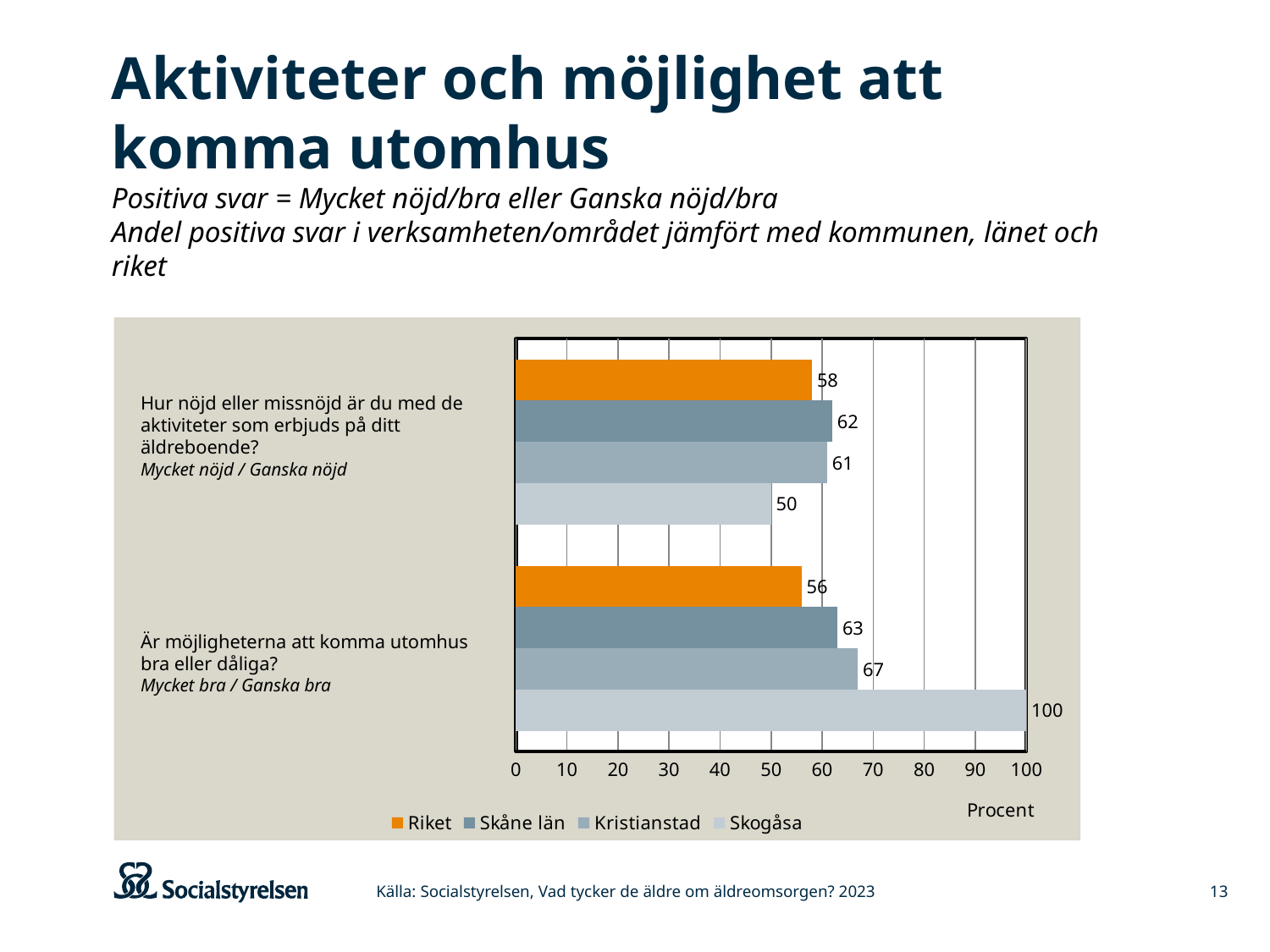
On the question about satisfaction with activities offered, which is larger: Skåne län or Riket? Skåne län What is the value for Kristianstad on the question about opportunities to get outdoors? 67 What is the value for Skogåsa on the question about satisfaction with activities offered? 50 What kind of chart is shown on the slide? Bar chart What is the difference between Skogåsa and Riket on the question about opportunities to get outdoors? 44 Which series is shown in orange in the legend? Riket Which series has the lowest value on the question about satisfaction with activities offered? Skogåsa What is the value for Skogåsa on the question about opportunities to get outdoors ("Är möjligheterna att komma utomhus bra eller dåliga?")? 100 Which series has the highest value on the question about opportunities to get outdoors? Skogåsa How many series does the legend list? 4 What is the difference between Skåne län and Skogåsa on the question about satisfaction with activities offered? 12 What is the value for Riket on the question about satisfaction with activities offered at the care home? 58